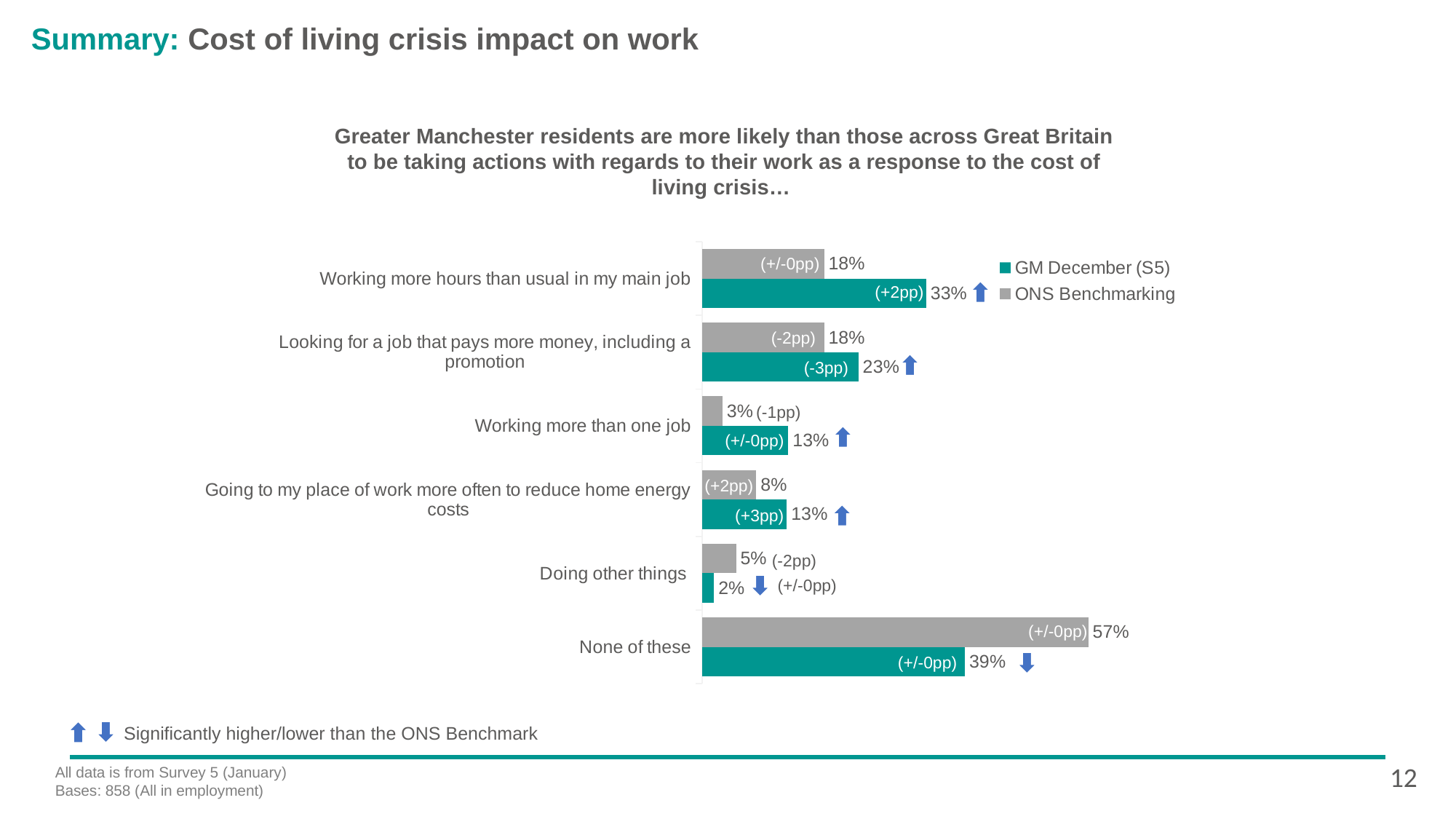
Which category has the highest GM December (S5) value? None of these What is the GM December (S5) value for 'Working more hours than usual in my main job'? 33% Which category has the lowest ONS Benchmarking value? Working more than one job What is the ONS Benchmarking value for 'Going to my place of work more often to reduce home energy costs'? 8% What is the difference between the GM December (S5) and ONS Benchmarking values for 'Working more hours than usual in my main job'? 15 percentage points How many series does the legend list? 2 What is the GM December (S5) value for 'Working more than one job'? 13% For 'Doing other things', which is larger: the GM December (S5) value or the ONS Benchmarking value? ONS Benchmarking How many categories are shown in the chart? 6 Which colour represents the ONS Benchmarking series? Grey What type of chart is shown on the slide? Bar chart What is the ONS Benchmarking value for 'None of these'? 57%